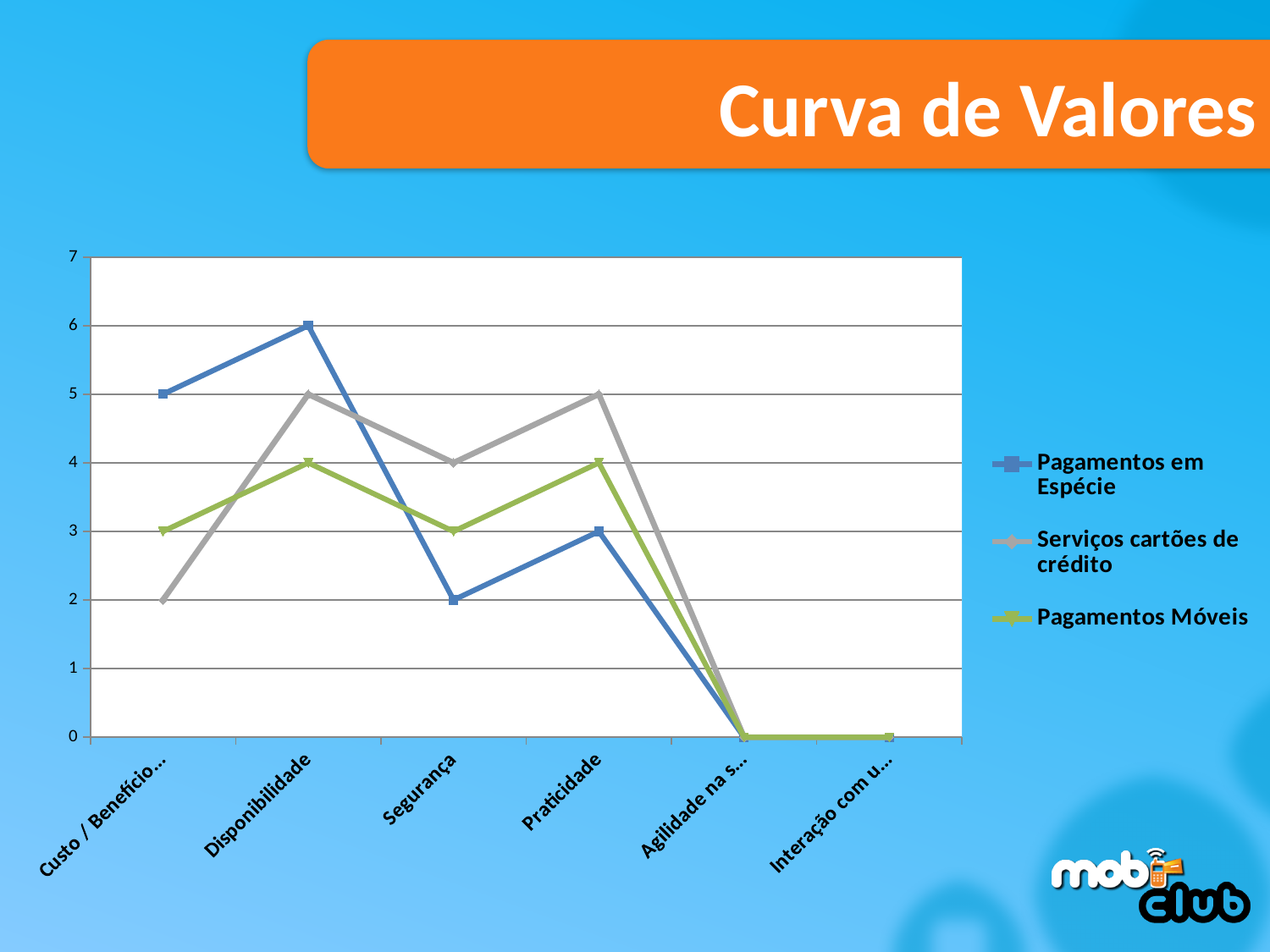
What is the difference between Serviços cartões de crédito and Pagamentos Móveis at Praticidade? 1 Which series has the lowest value at Segurança? Pagamentos em Espécie What kind of chart is shown on the slide? line chart How many categories are shown on the x axis? 6 What is the value for Pagamentos em Espécie at Segurança? 2 At Disponibilidade, which is larger: Pagamentos em Espécie or Pagamentos Móveis? Pagamentos em Espécie At which category does Pagamentos em Espécie reach its highest value? Disponibilidade How many series does the legend list? 3 What is the value for Serviços cartões de crédito at Segurança? 4 What is the value for Pagamentos Móveis at Praticidade? 4 What is the value for Pagamentos em Espécie at Disponibilidade? 6 What is the title of the slide containing the chart? Curva de Valores